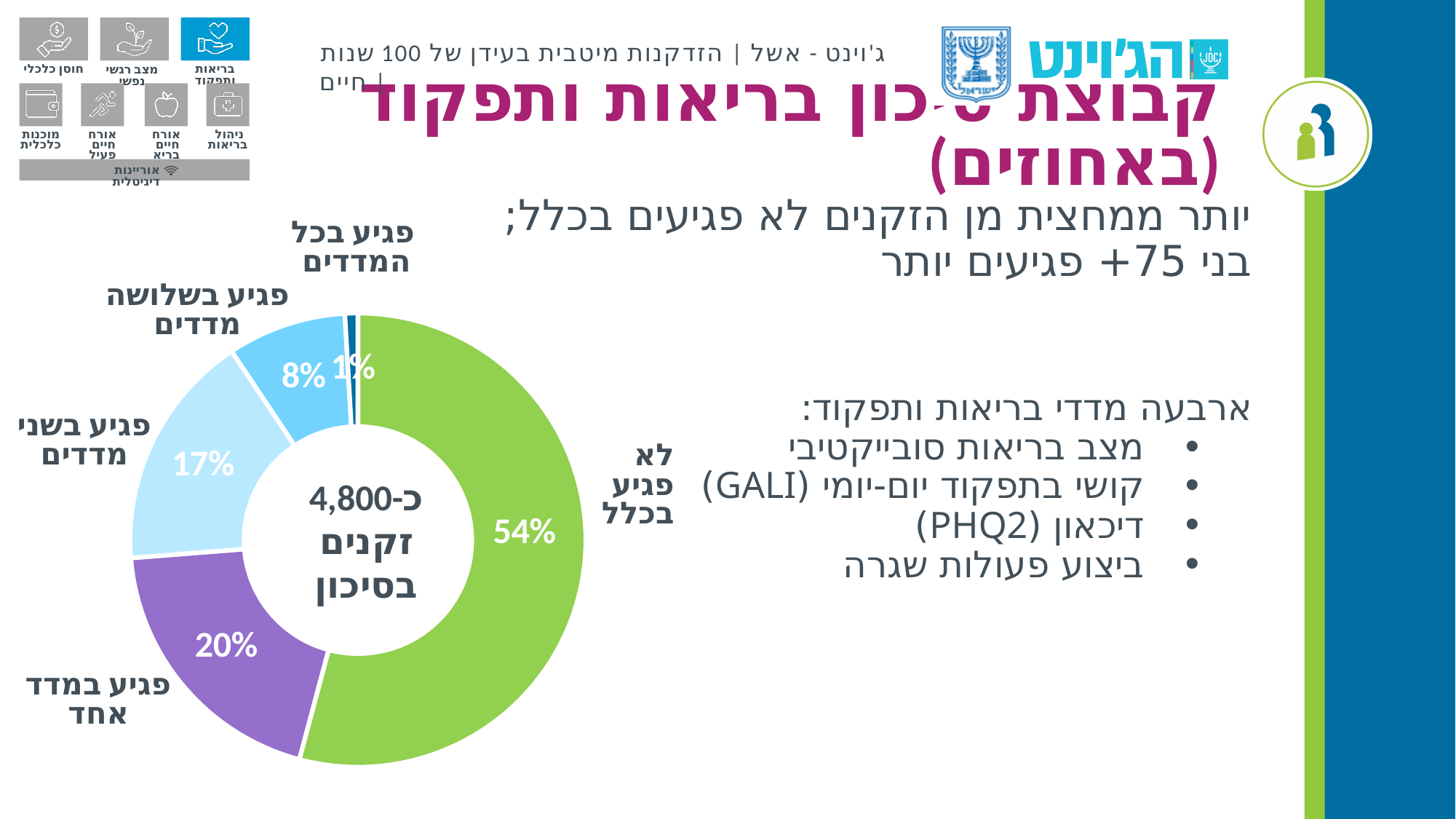
Which is larger: the slice for "פגיע בשני מדדים" or the slice for "פגיע בשלושה מדדים"? פגיע בשני מדדים What percentage of the pie chart is labelled "פגיע בשלושה מדדים"? 8% What is the difference in percentage points between "לא פגיע בכלל" and "פגיע במדד אחד"? 34 What percentage of the pie chart is labelled "לא פגיע בכלל"? 54% What text appears in the centre of the donut chart? כ-4,800 זקנים בסיכון What percentage of the pie chart is labelled "פגיע בשני מדדים"? 17% What kind of chart is shown on the slide? Doughnut chart Which category has the smallest slice in the pie chart? פגיע בכל המדדים How many slices does the pie chart have? 5 Which category has the largest slice in the pie chart? לא פגיע בכלל What percentage of the pie chart is labelled "פגיע בכל המדדים"? 1% What percentage of the pie chart is labelled "פגיע במדד אחד"? 20%